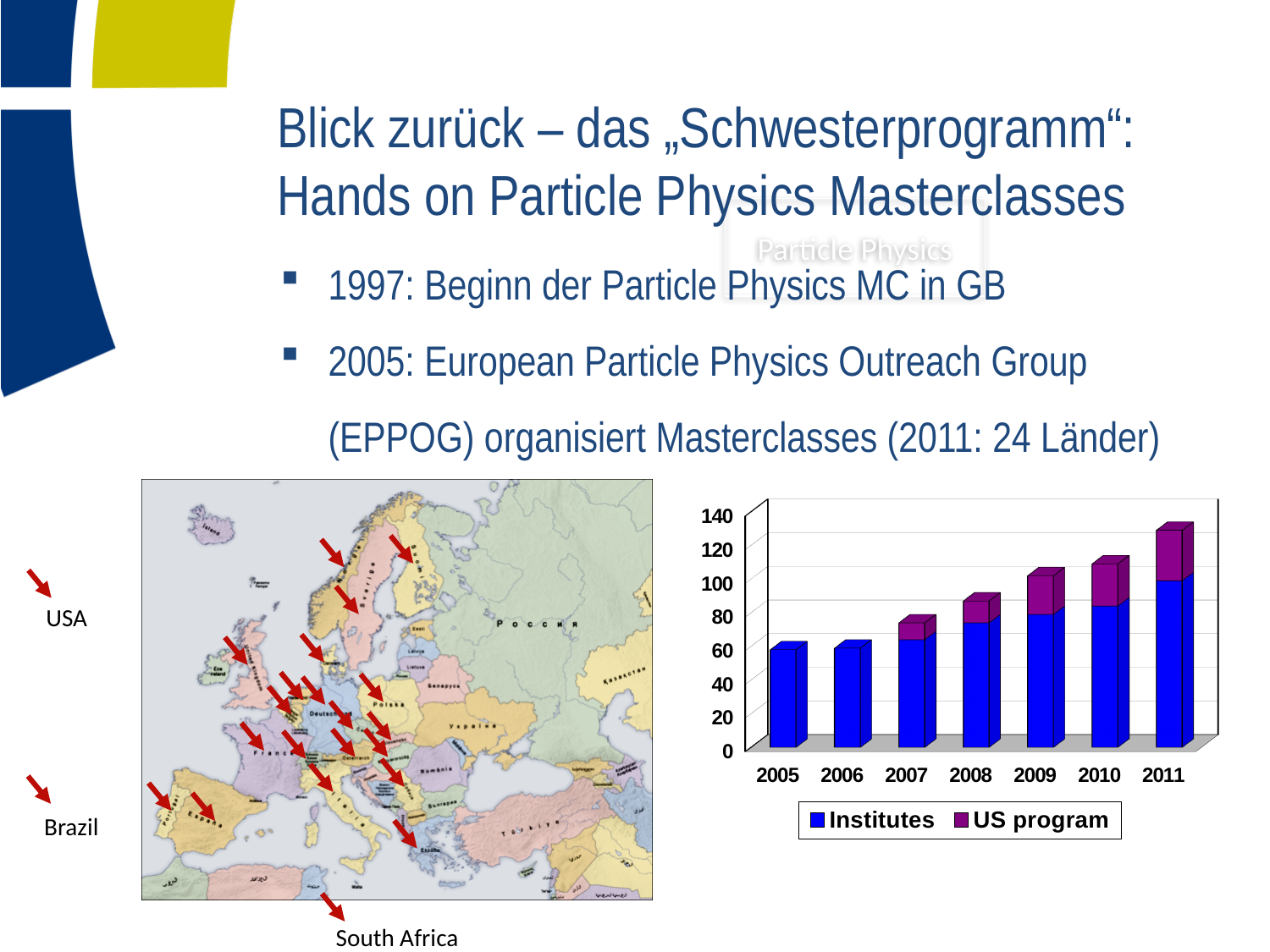
Which series are listed in the legend of the bar chart? Institutes and US program Is the total stacked bar for 2008 greater or less than 100? less What colour represents the US program series in the bar chart? purple How many years are shown on the x axis of the bar chart? 7 Which year has the tallest stacked bar in the chart? 2011 Is the Institutes value for 2011 greater or less than 80? greater Do the total bar heights generally rise or fall from 2005 to 2011? rise What kind of chart is shown on the right of the slide? stacked bar chart Is the Institutes value for 2005 greater or less than 80? less In 2011, which series has the larger value, Institutes or US program? Institutes How many series does the legend of the bar chart list? 2